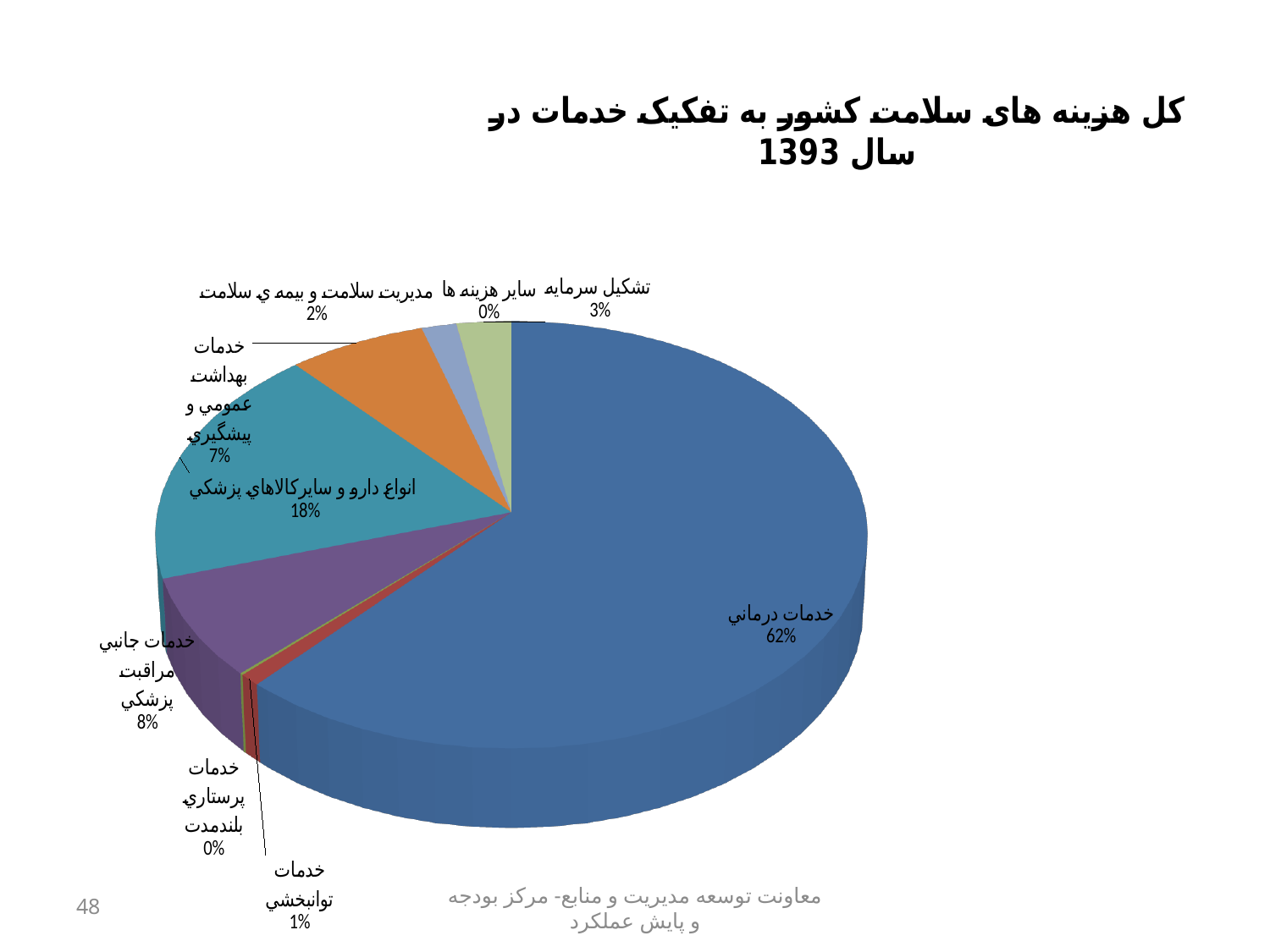
What percentage is shown for خدمات جانبي مراقبت پزشكي (ancillary medical care services)? 8% Which is larger, the share for خدمات جانبي مراقبت پزشكي or the share for خدمات بهداشت عمومي و پيشگيري? خدمات جانبي مراقبت پزشكي What percentage is shown for خدمات توانبخشي (rehabilitation services)? 1% Which category has the largest share of the pie? خدمات درماني What kind of chart is shown on the slide? pie chart What is the difference in percentage points between خدمات درماني (62%) and انواع دارو و سايركالاهاي پزشكي (18%)? 44 percentage points What percentage is shown for انواع دارو و سايركالاهاي پزشكي (drugs and other medical goods)? 18% What share of the pie does خدمات درماني (treatment services) have? 62% What percentage is shown for تشكيل سرمايه (capital formation)? 3% How many categories (slices) are labelled in the pie chart? 9 Which year does the chart title say the health expenditure data is for? 1393 What percentage is shown for خدمات بهداشت عمومي و پيشگيري (public health and prevention services)? 7%